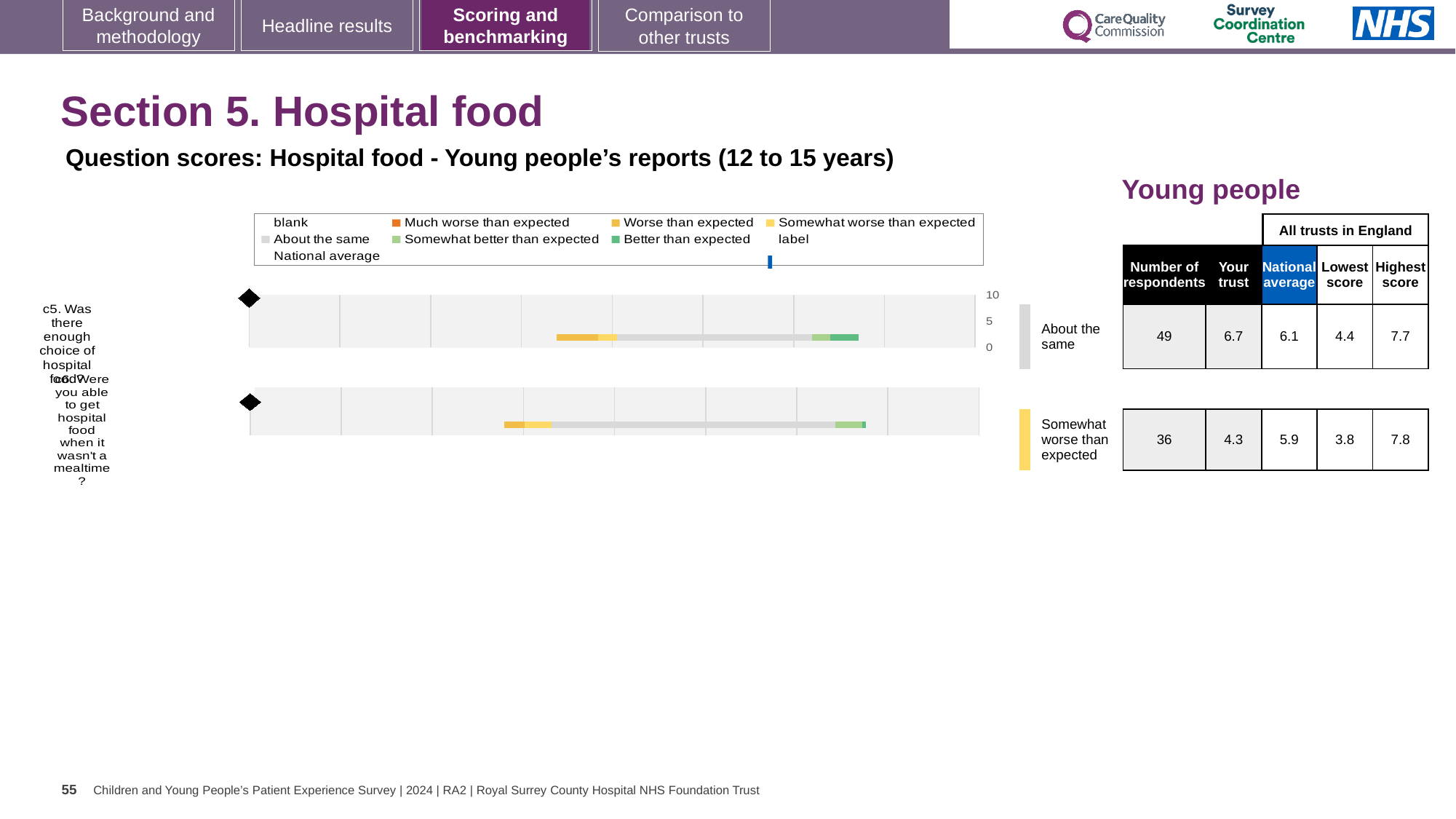
How many respondents answered question c5 (Was there enough choice of hospital food?)? 49 What is the highest value shown on the chart's score axis? 10 What kind of chart is used to show the question scores on this slide? bar chart What is the national average score for question c5? 6.1 What is the subtitle of the chart on this slide? Question scores: Hospital food - Young people's reports (12 to 15 years) Which question has the higher 'Your trust' score, c5 or c6? c5 What is the highest score across all trusts in England for question c6? 7.8 How many survey questions are plotted in the chart? 2 What is the 'Your trust' score for question c6 (Were you able to get hospital food when it wasn't a mealtime?)? 4.3 What benchmark category is question c6 rated as? Somewhat worse than expected What is the difference between the highest score and the lowest score for question c5? 3.3 How many more respondents answered question c5 than question c6? 13